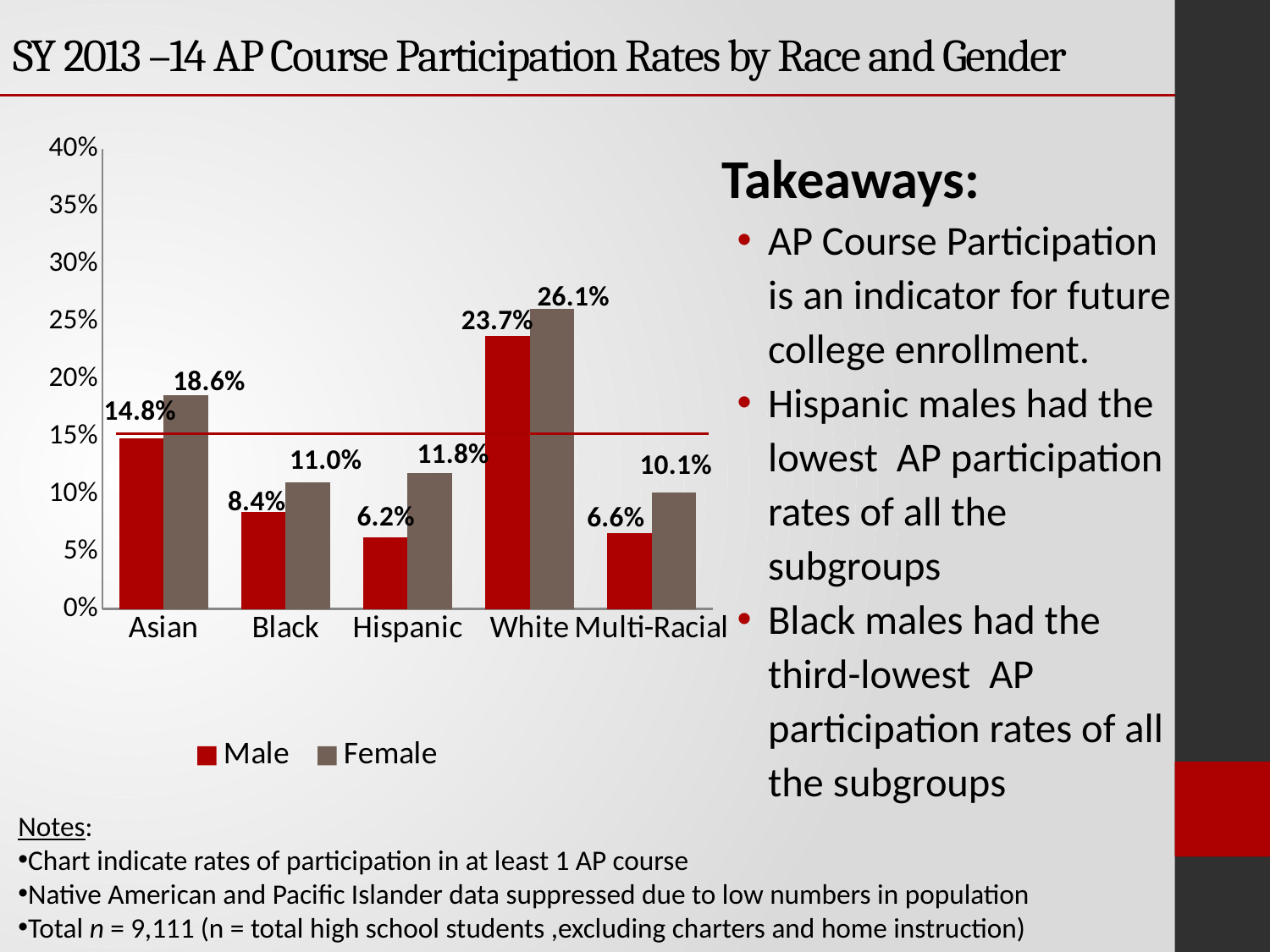
Which category has the lowest Male participation rate? Hispanic Which category has the highest Female participation rate? White How many series does the legend list? 2 What is the AP course participation rate for White females? 26.1% How many race categories are shown on the x axis? 5 Which is larger, the Female rate for Black students or the Female rate for Hispanic students? Hispanic What is the difference between the Female and Male participation rates for White students? 2.4% What is the AP course participation rate for Multi-Racial males? 6.6% What colour represents the Male series in the chart? red Is the Male participation rate for Asian students greater or less than 10%? greater What kind of chart is shown on the slide? bar chart What is the AP course participation rate for Asian males? 14.8%